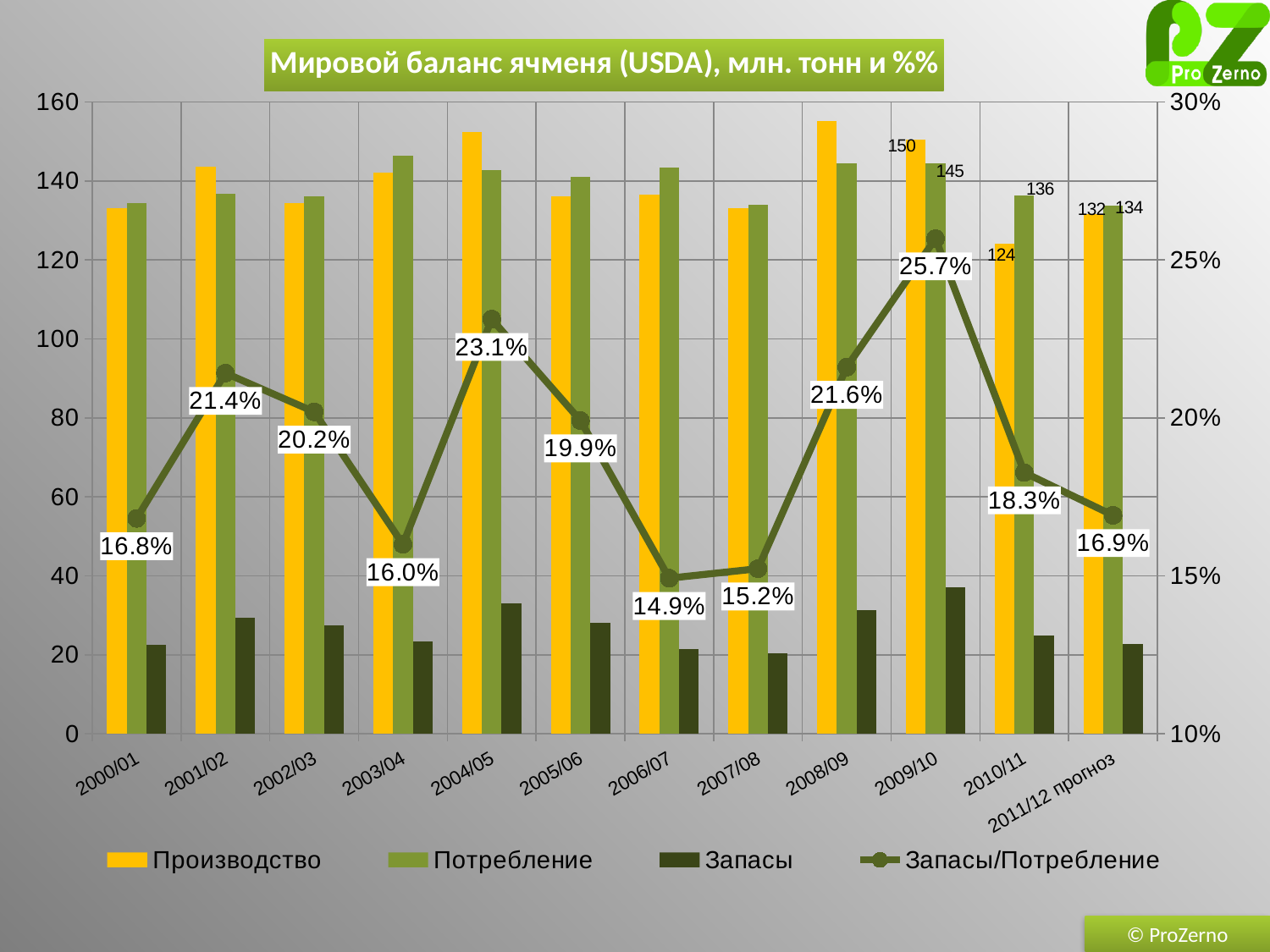
Does the Запасы/Потребление line rise or fall from 2009/10 to 2011/12 прогноз? fall What is the Потребление value for 2011/12 прогноз? 134 How many series does the legend list? 4 What is the difference between Потребление and Производство in 2010/11? 12 What is the Запасы/Потребление value for 2009/10? 25.7% How many seasons are shown on the x axis? 12 In which season is the Запасы/Потребление ratio the highest? 2009/10 Is the Запасы value for 2009/10 greater or less than 20? greater What is the Производство value for 2010/11? 124 Is the Производство value for 2008/09 greater or less than 140? greater In which season is the Запасы/Потребление ratio the lowest? 2006/07 Which is larger in 2009/10: Производство or Потребление? Производство